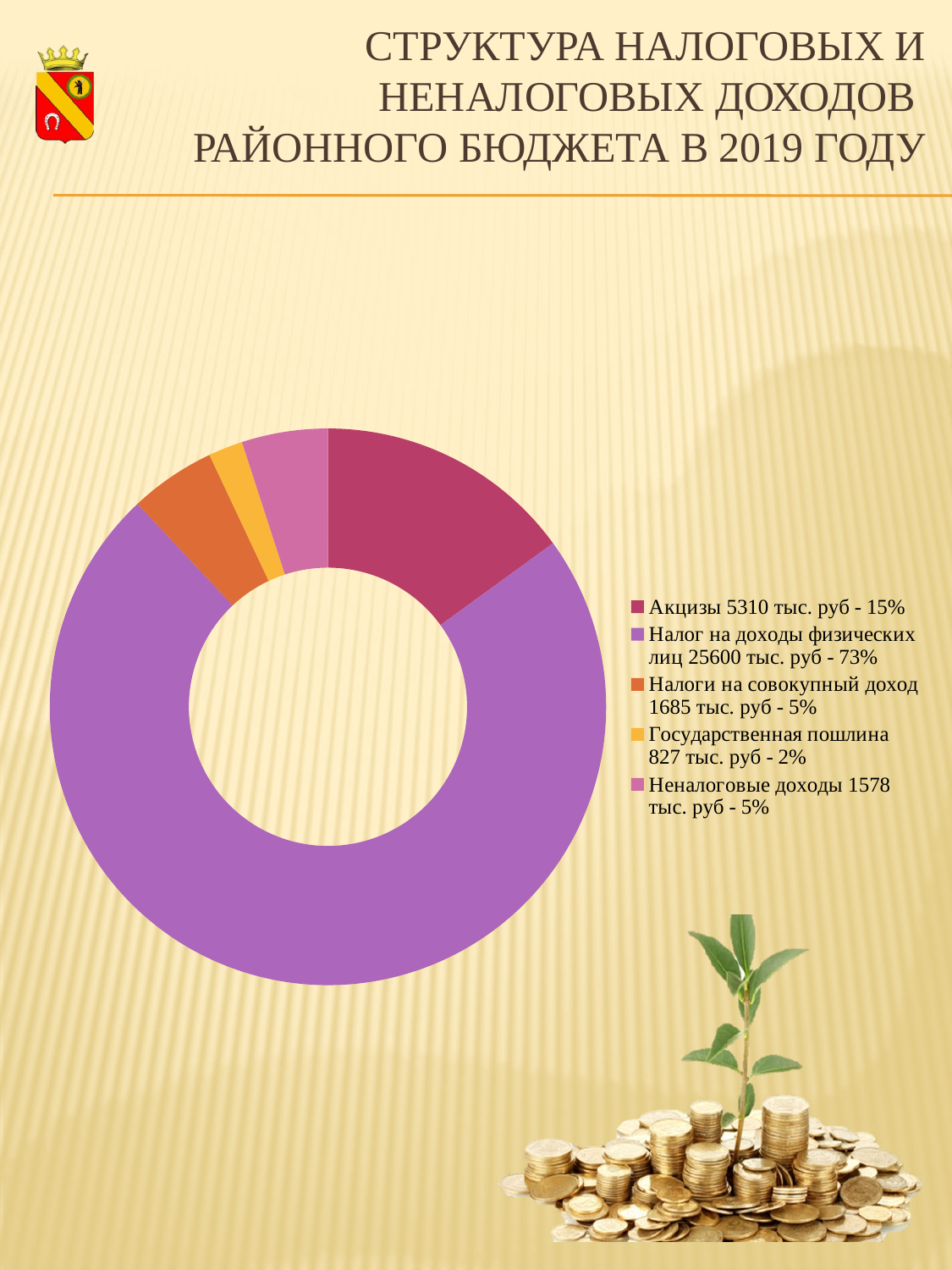
Which category has the smallest value? Государственная пошлина Which is larger, the value for Налоги на совокупный доход or the value for Неналоговые доходы? Налоги на совокупный доход Which category has the largest value? Налог на доходы физических лиц What share of the chart does Налог на доходы физических лиц represent? 73% What colour is the segment for Государственная пошлина? yellow/orange How many categories does the chart's legend list? 5 What kind of chart is shown on the slide? doughnut chart What is the value for Государственная пошлина? 827 тыс. руб What is the value for Налог на доходы физических лиц? 25600 тыс. руб What is the difference between the values for Акцизы and Налоги на совокупный доход? 3625 тыс. руб What share of the chart does Акцизы represent? 15% What is the value for Акцизы? 5310 тыс. руб